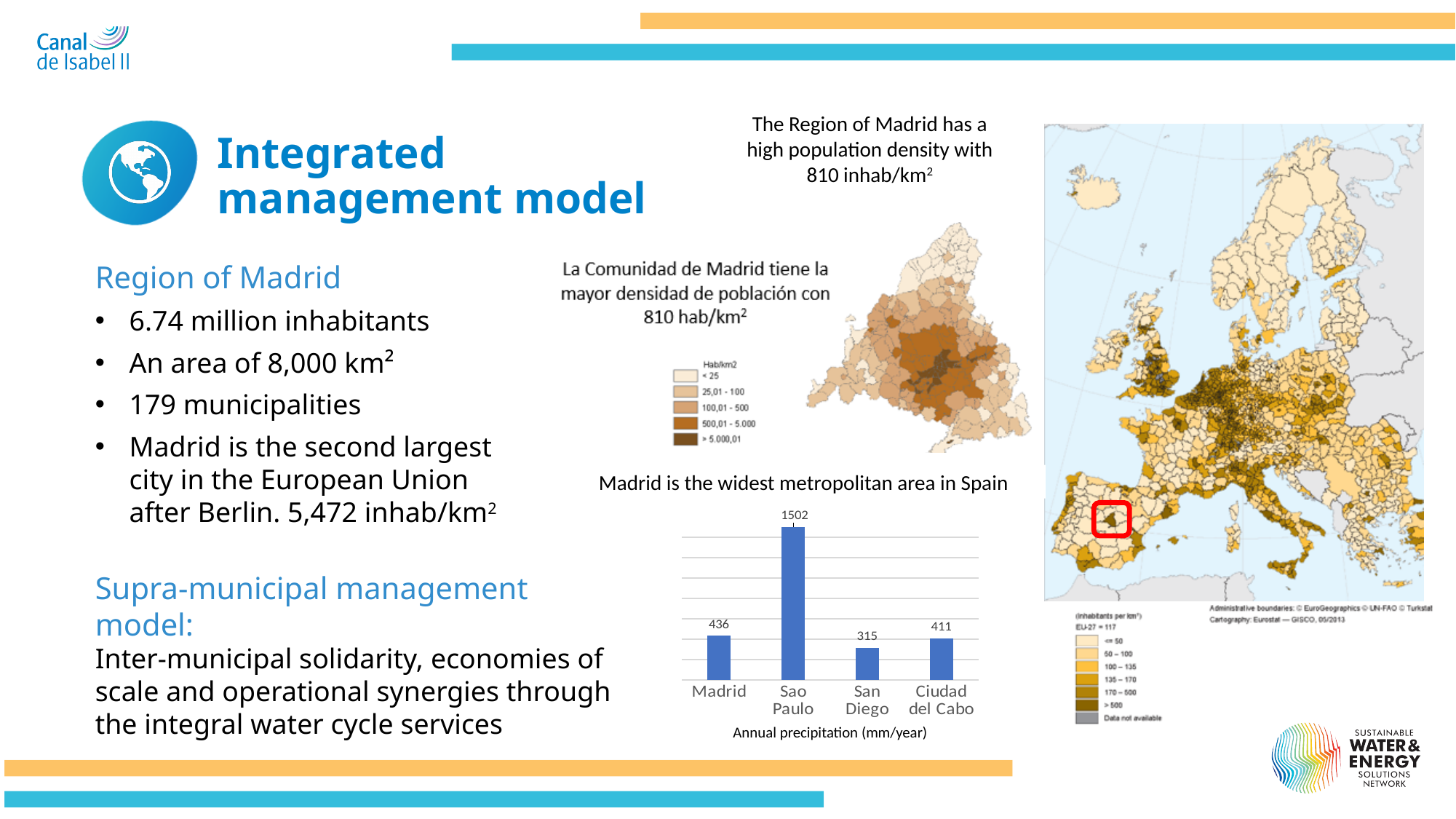
In the annual precipitation bar chart, what is the value for Madrid? 436 In the annual precipitation bar chart, which city has the lowest value? San Diego What unit is given in the axis title of the annual precipitation bar chart? mm/year In the annual precipitation bar chart, what is the value for Ciudad del Cabo? 411 In the annual precipitation bar chart, what is the value for Sao Paulo? 1502 In the annual precipitation bar chart, what is the difference between the values for Sao Paulo and Madrid? 1066 In the annual precipitation bar chart, which is larger, the value for Madrid or the value for San Diego? Madrid What kind of chart is used to show annual precipitation on the slide? Bar chart In the annual precipitation bar chart, which city has the highest value? Sao Paulo In the annual precipitation bar chart, what is the difference between the values for Madrid and Ciudad del Cabo? 25 In the annual precipitation bar chart, what is the value for San Diego? 315 How many cities are shown in the annual precipitation bar chart? 4